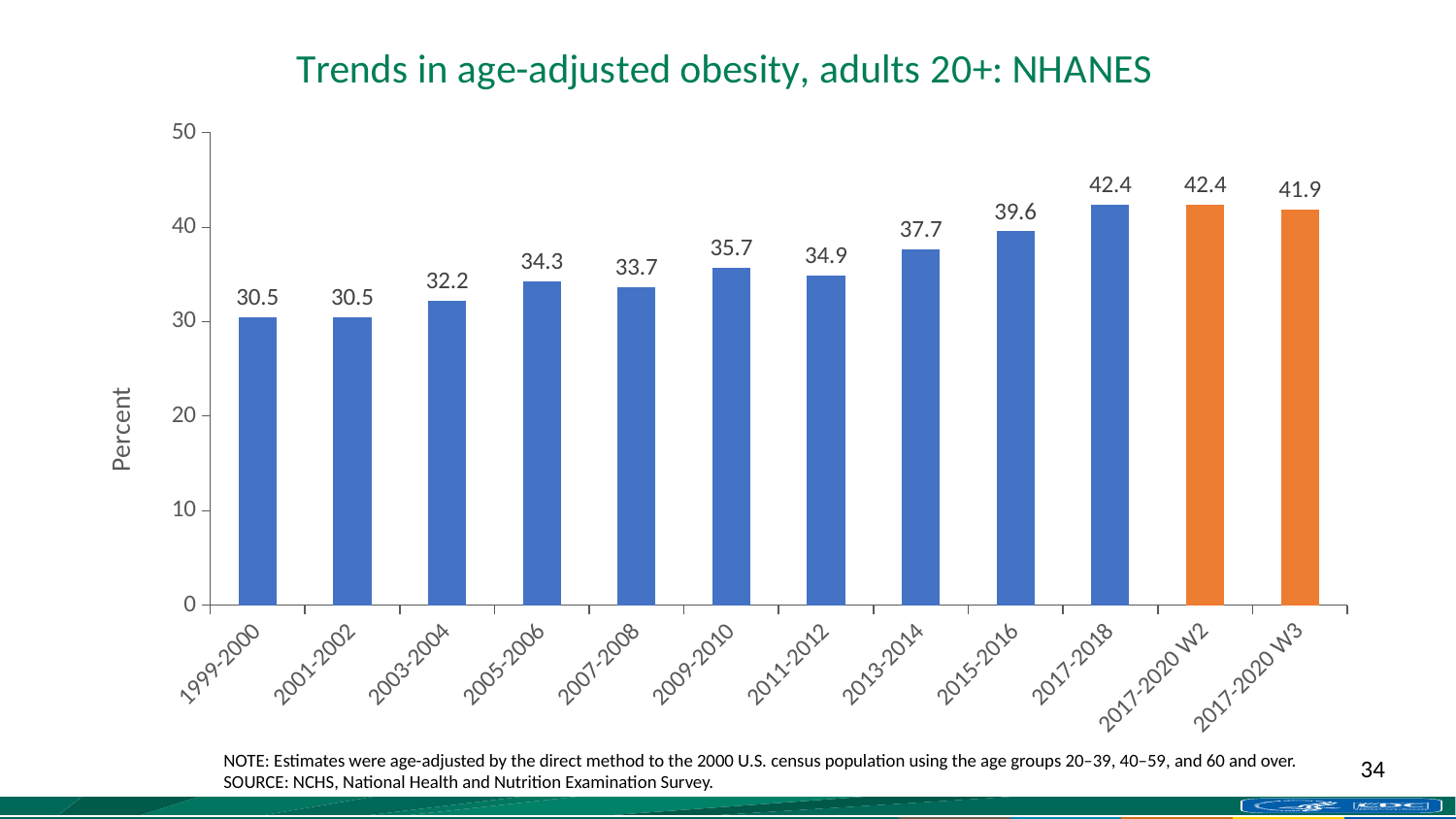
How many categories are shown on the x axis? 12 What is the label on the y axis? Percent What is the title of the chart? Trends in age-adjusted obesity, adults 20+: NHANES Which category has the lowest value? 1999-2000 and 2001-2002 (both 30.5) Which is larger, the value for 2009-2010 or the value for 2011-2012? 2009-2010 Is the value for 2015-2016 greater or less than 40? less What is the value for 2017-2020 W3? 41.9 What is the difference between the values for 2017-2018 and 1999-2000? 11.9 What kind of chart is this? bar chart What is the value for 1999-2000? 30.5 What is the value for 2013-2014? 37.7 Do the values generally rise or fall from 1999-2000 to 2017-2018? rise